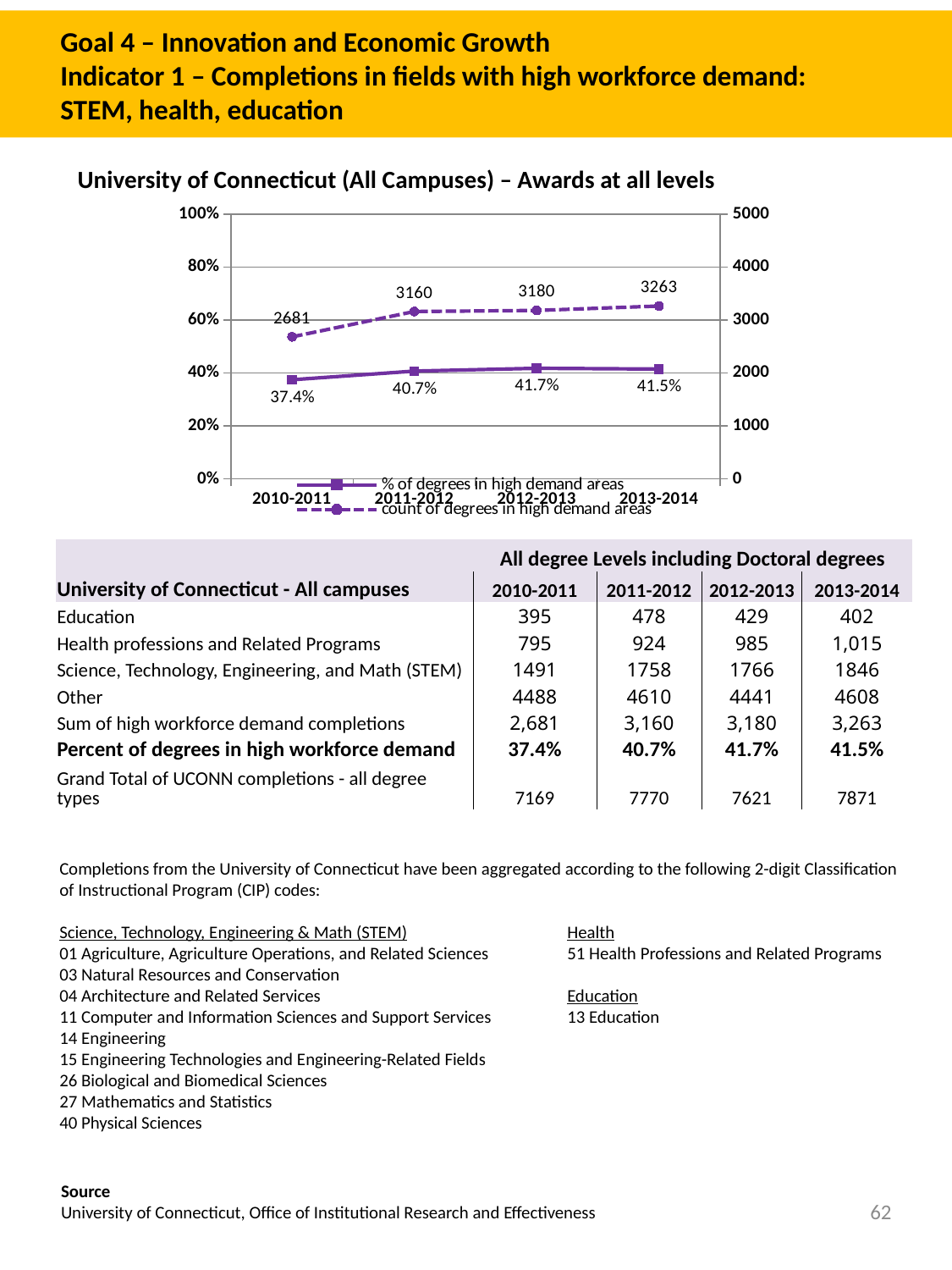
What kind of chart is shown on the slide? line chart Is the value of '% of degrees in high demand areas' for 2013-2014 greater or less than 60%? less What is the value of '% of degrees in high demand areas' for 2010-2011? 37.4% What is the value of 'count of degrees in high demand areas' for 2013-2014? 3263 Does 'count of degrees in high demand areas' rise or fall from 2010-2011 to 2013-2014? rise How many years are shown on the x axis of the chart? 4 What is the difference in 'count of degrees in high demand areas' between 2013-2014 and 2010-2011? 582 Which year has the larger 'count of degrees in high demand areas', 2011-2012 or 2013-2014? 2013-2014 How many series does the chart legend list? 2 In which year is '% of degrees in high demand areas' highest? 2012-2013 What is the value of 'count of degrees in high demand areas' for 2011-2012? 3160 In which year is 'count of degrees in high demand areas' lowest? 2010-2011